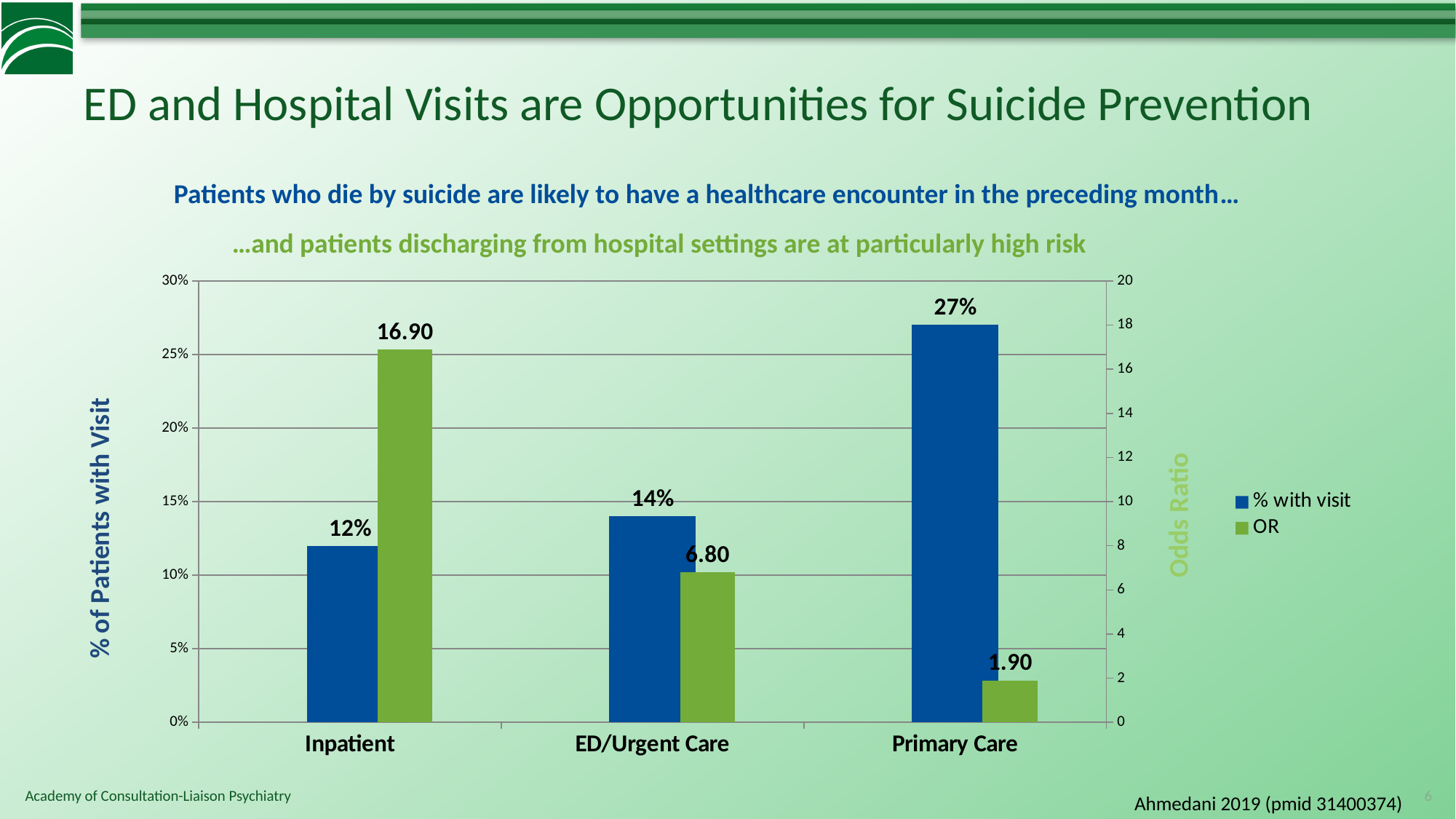
What is the % with visit value for Primary Care? 27% What is the difference between the % with visit values for Primary Care and ED/Urgent Care? 13% What is the difference between the OR values for Inpatient and ED/Urgent Care? 10.10 How many series does the legend list? 2 How many categories are shown on the x axis? 3 Which category has the lowest % with visit value? Inpatient What kind of chart is shown on the slide? Bar chart What is the OR (odds ratio) value for ED/Urgent Care? 6.80 Which category has the highest OR value? Inpatient What is the OR value for Primary Care? 1.90 Which is larger, the OR for Inpatient or the OR for Primary Care? Inpatient What is the % with visit value for Inpatient? 12%